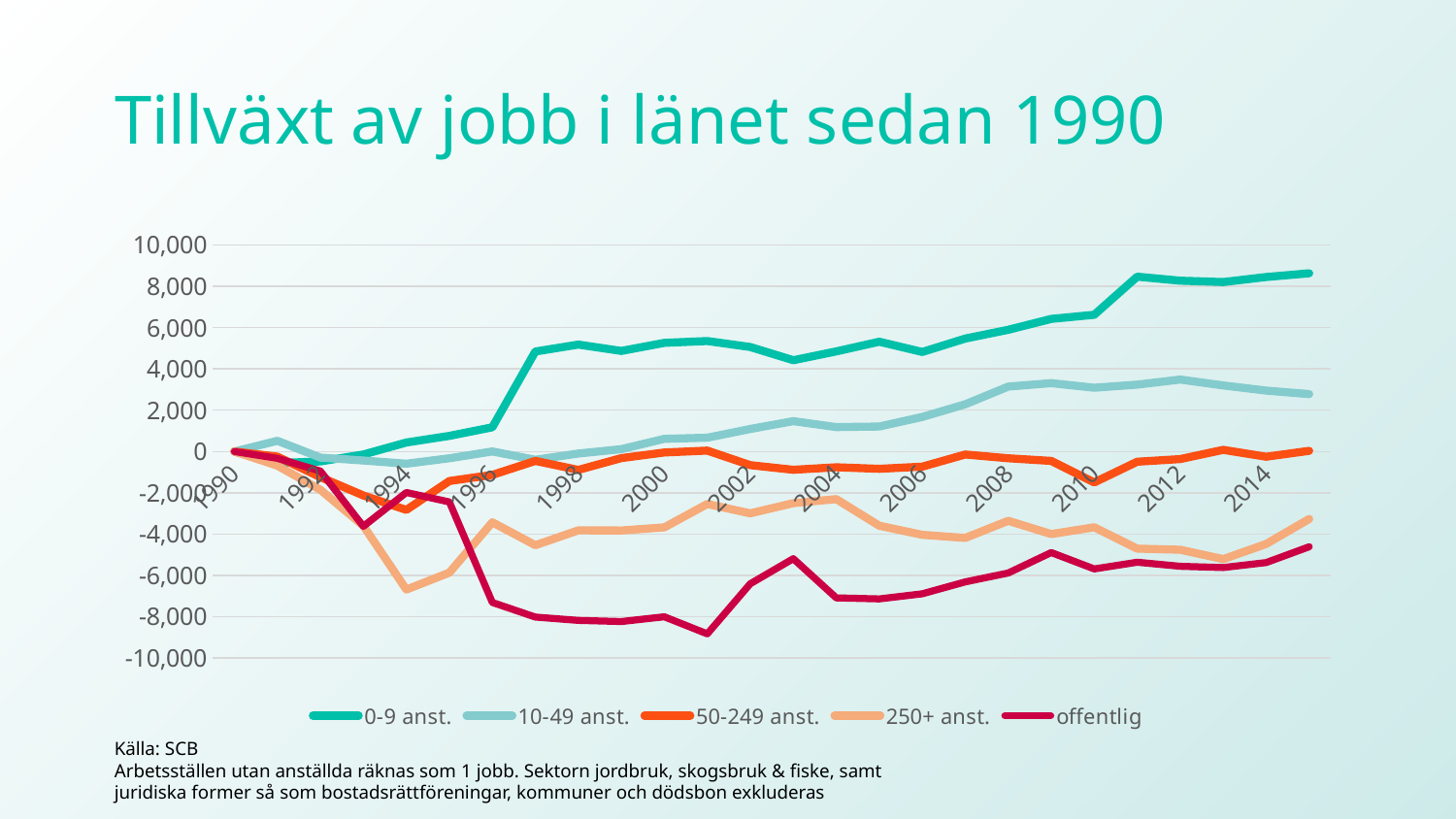
Is the value for 0-9 anst. in 2012 greater or less than 6,000? greater Which series has the highest value at the right end of the chart (2014)? 0-9 anst. In 2006, which series has the larger value: 50-249 anst. or 250+ anst.? 50-249 anst. What kind of chart is shown on the slide? line chart Is the value for offentlig in 2000 greater or less than -6,000? less Which series has the lowest value at the right end of the chart (2014)? offentlig Is the value for 250+ anst. in 1994 greater or less than -4,000? less How many series does the legend list? 5 Which series reaches the lowest point anywhere on the chart? offentlig What is the title of the chart on the slide? Tillväxt av jobb i länet sedan 1990 Does the 0-9 anst. series rise or fall overall from 1990 to 2014? rise